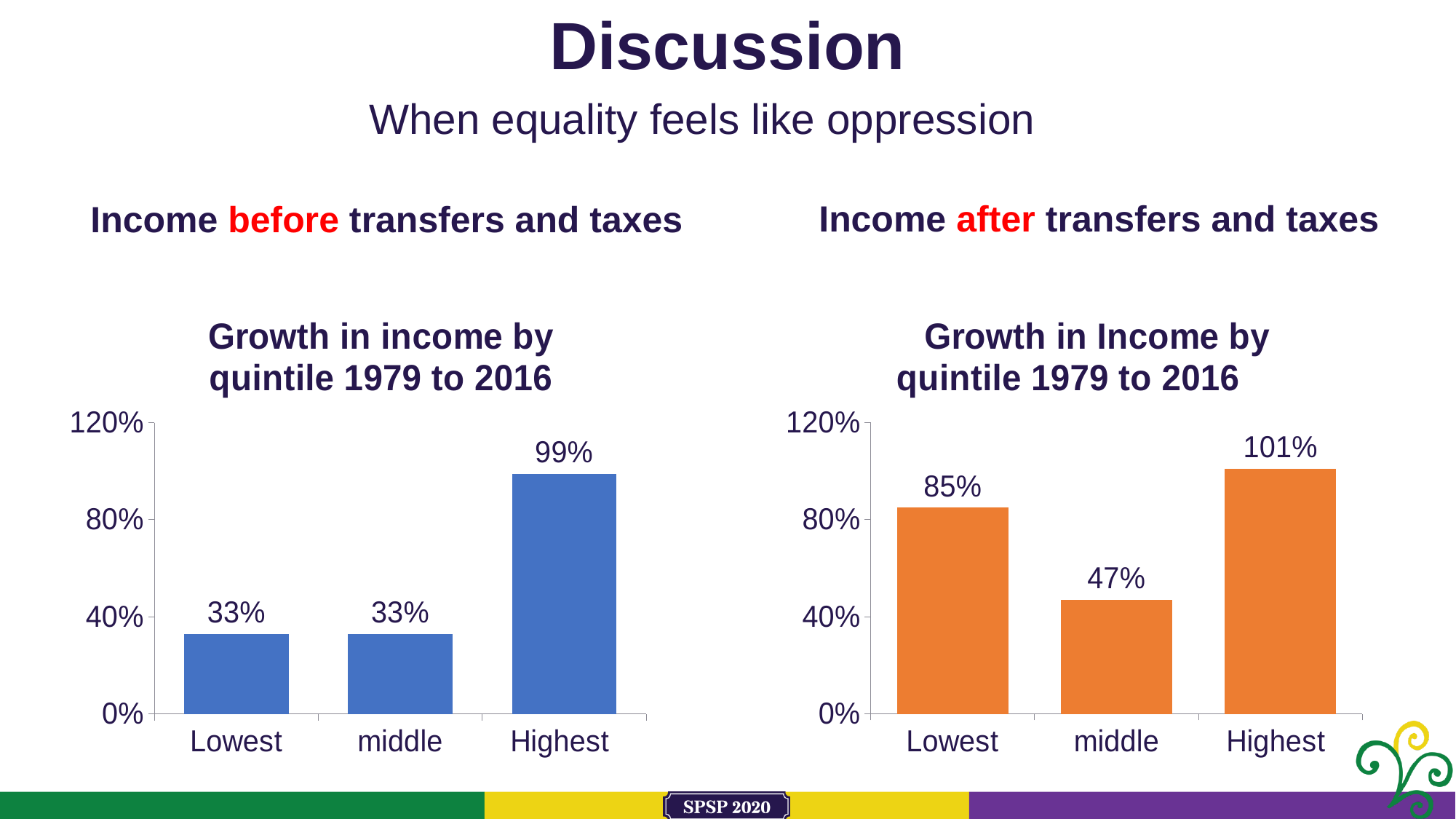
In the left chart (Income before transfers and taxes), is the value for the Lowest quintile greater or less than 40%? less In the right chart (Income after transfers and taxes), what is the difference between the Highest and Lowest quintile values? 16% In the left chart (Income before transfers and taxes), what is the difference between the Highest and middle quintile values? 66% In the left chart (Income before transfers and taxes), which quintile has the highest growth? Highest What colour are the bars in the right chart (Income after transfers and taxes)? orange In the left chart (Income before transfers and taxes), what is the value for the Highest quintile? 99% In the right chart (Income after transfers and taxes), which is larger, the value for Lowest or the value for middle? Lowest In the right chart (Income after transfers and taxes), what is the value for the Lowest quintile? 85% In the right chart (Income after transfers and taxes), which quintile has the lowest growth? middle What kind of chart is the left chart (Income before transfers and taxes)? bar chart In the right chart (Income after transfers and taxes), what is the value for the middle quintile? 47% How many quintile categories are shown in the right chart (Income after transfers and taxes)? 3